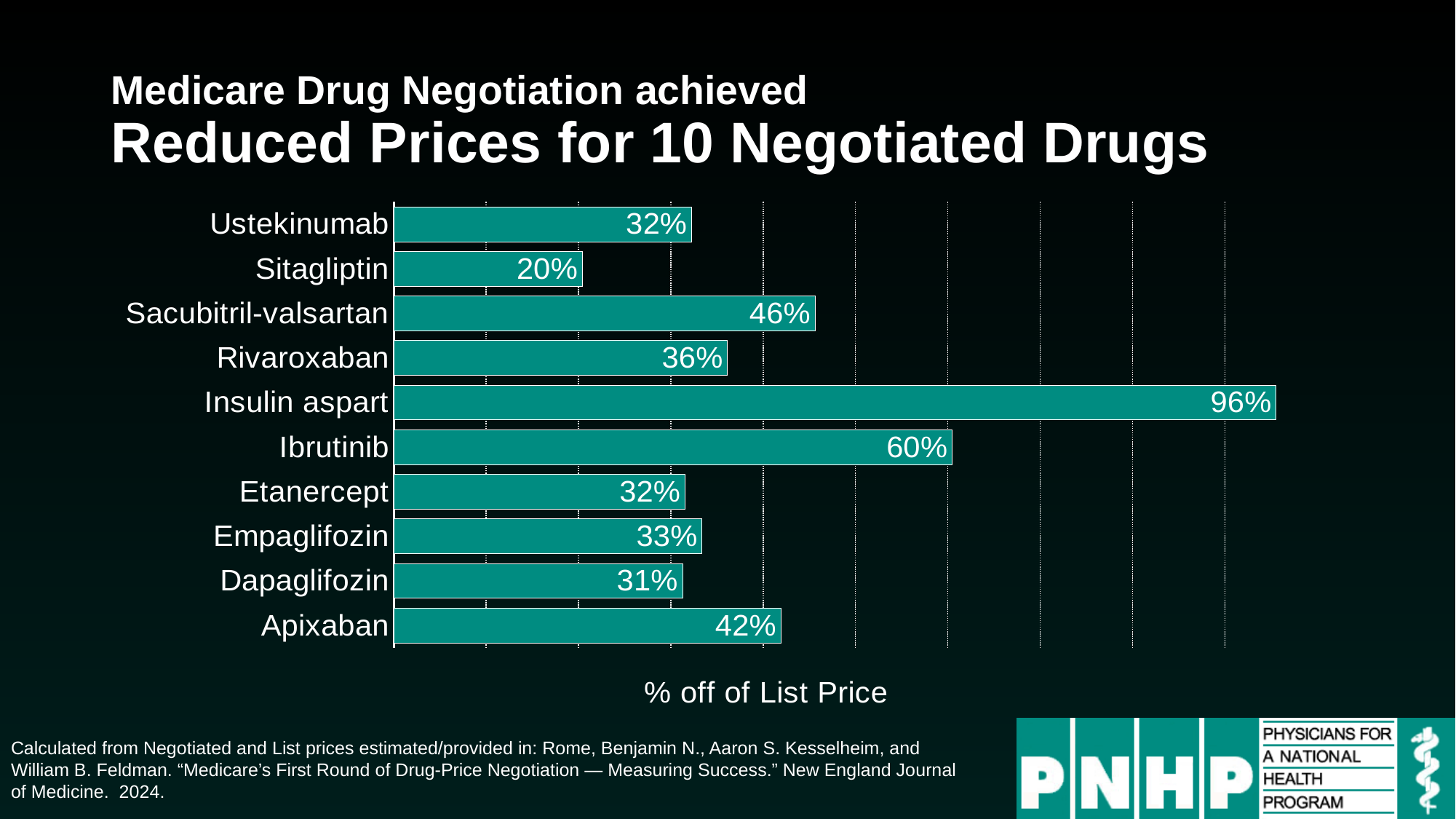
What kind of chart is shown on the slide? Bar chart What is the % off of list price for Insulin aspart? 96% What is the difference in % off of list price between Sacubitril-valsartan and Rivaroxaban? 10% Which has a larger % off of list price, Empaglifozin or Dapaglifozin? Empaglifozin Which drug has the lowest % off of list price? Sitagliptin Which has a larger % off of list price, Ibrutinib or Apixaban? Ibrutinib How many drugs are shown in the chart? 10 What is the difference in % off of list price between Insulin aspart and Ibrutinib? 36% What is the % off of list price for Apixaban? 42% What is the % off of list price for Sacubitril-valsartan? 46% What is the % off of list price for Sitagliptin? 20% Which drug has the highest % off of list price? Insulin aspart